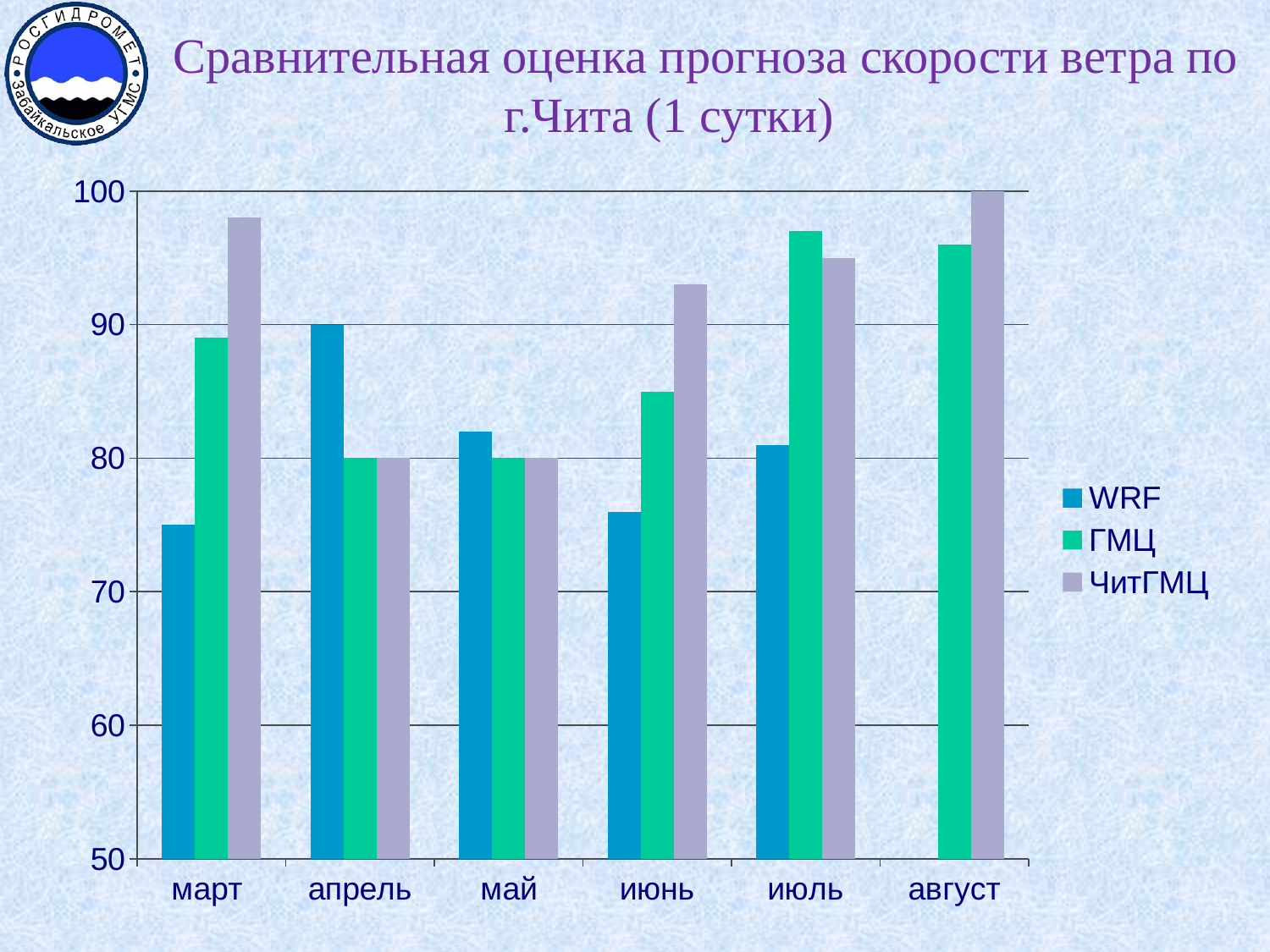
How many series does the legend list? 3 Is the WRF value for март greater or less than 80? less Is the ГМЦ value for июнь greater or less than 80? greater Is the WRF value for июль greater or less than 90? less What are the three series named in the legend? WRF, ГМЦ, ЧитГМЦ In which month is the ЧитГМЦ value the highest? август What kind of chart is shown on the slide? bar chart In июль, which is larger: the WRF value or the ГМЦ value? ГМЦ How many months are shown on the x axis? 6 Which series has no bar for август? WRF In апрель, which series has the highest value? WRF